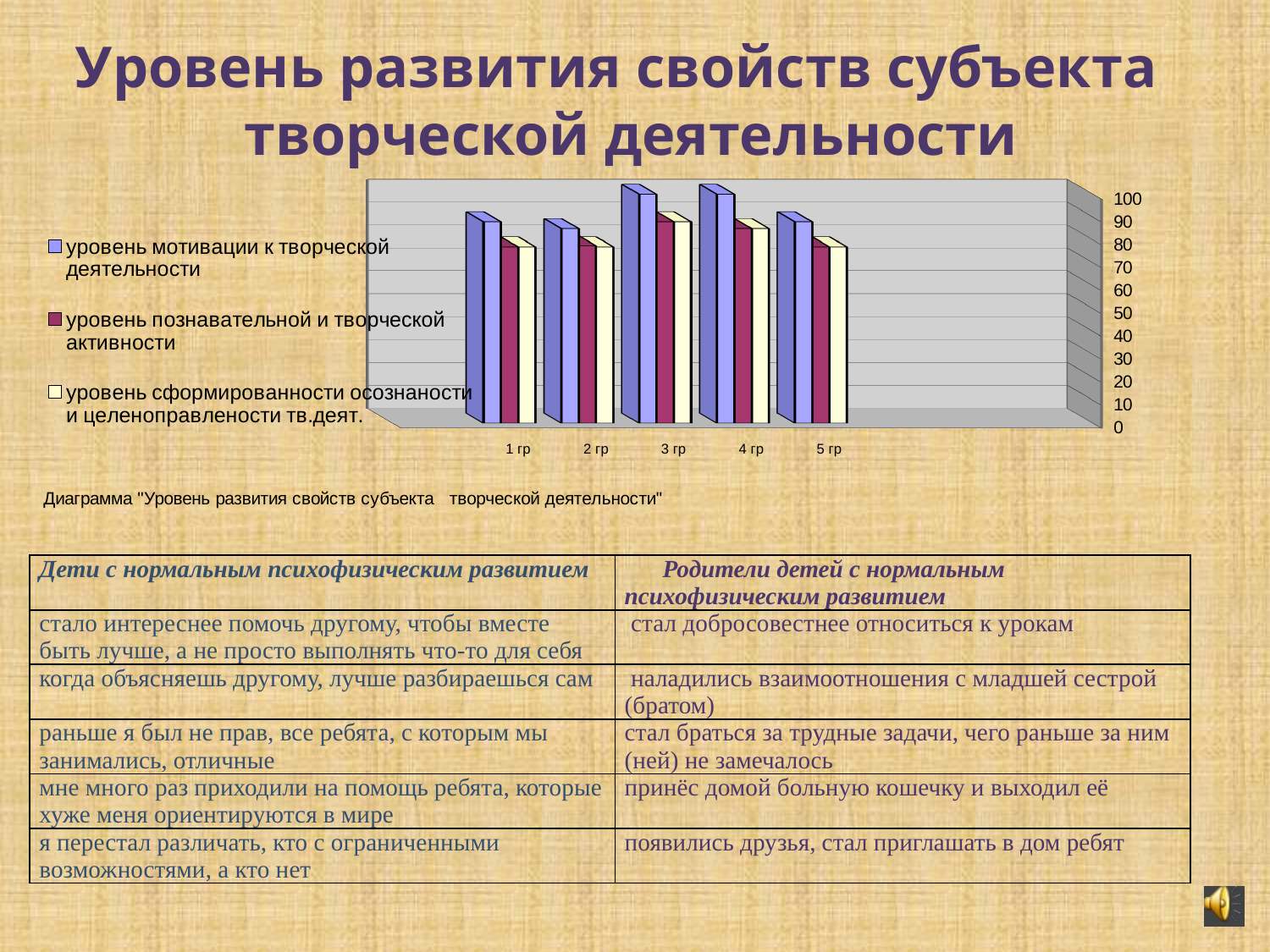
In group 1 гр, which series has the tallest bar? уровень мотивации к творческой деятельности Is the value for уровень мотивации к творческой деятельности in group 1 гр greater or less than 60? greater How many groups (categories) are shown along the x axis of the chart? 5 In group 3 гр, is the bar for уровень мотивации к творческой деятельности larger or smaller than the bar for уровень познавательной и творческой активности? larger What kind of chart is shown on the slide? bar chart Is the value for уровень познавательной и творческой активности in group 1 гр greater or less than 90? less Is the value for уровень мотивации к творческой деятельности in group 3 гр greater or less than 50? greater How many series does the chart legend list? 3 Which series does the blue bar represent in the chart? уровень мотивации к творческой деятельности What is the highest value shown on the chart's vertical axis? 100 In group 2 гр, is the bar for уровень мотивации к творческой деятельности larger or smaller than the bar for уровень сформированности осознаности и целенаправлености тв.деят.? larger